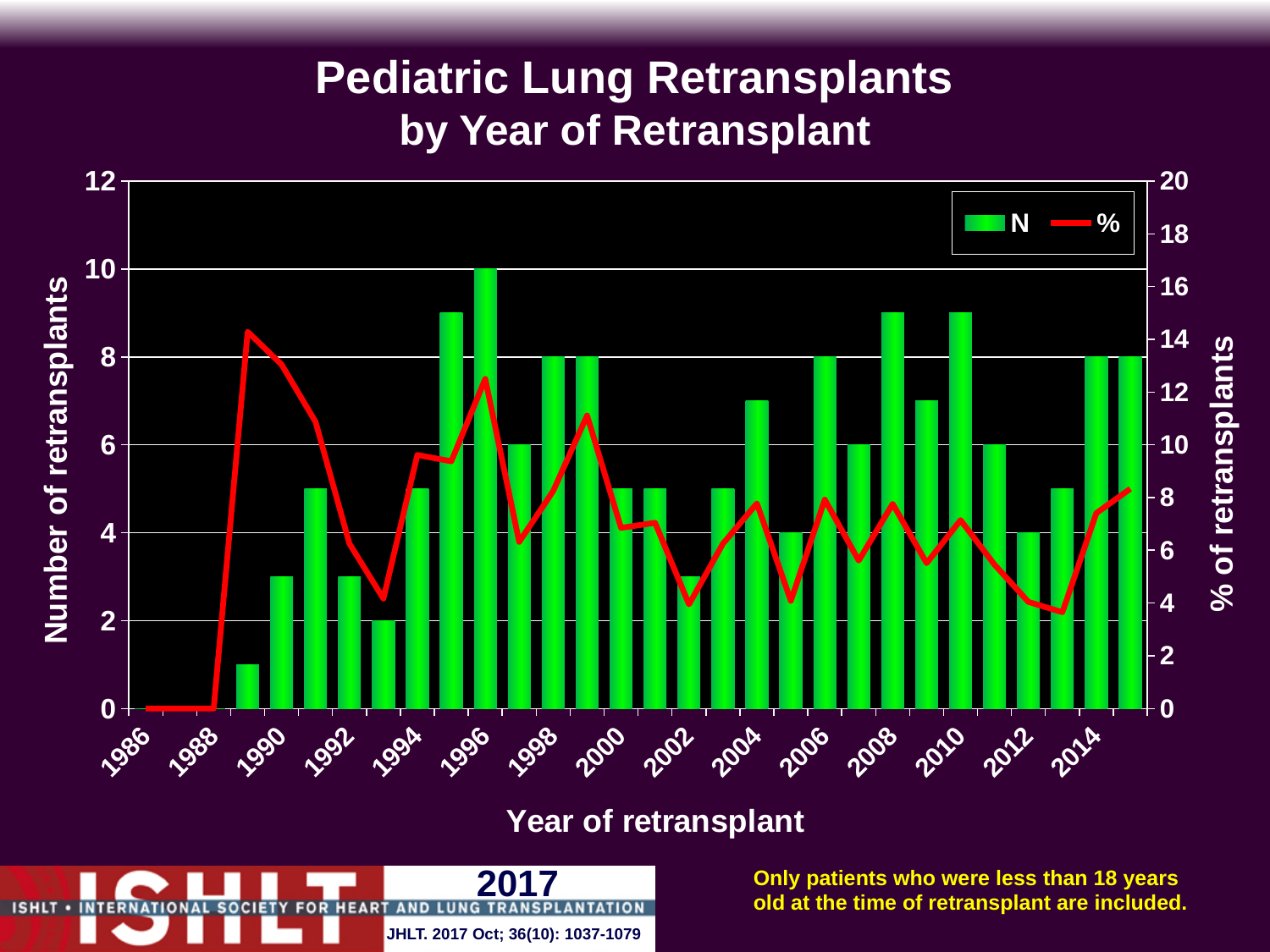
What is the number of retransplants (N) in 1996? 10 What is the number of retransplants (N) in 2012? 4 Is the number of retransplants in 2008 greater or less than 8? greater Do the number of retransplants rise or fall from 2010 to 2012? fall What is the difference in number of retransplants between 1996 and 1998? 2 Which year has more retransplants, 2006 or 2012? 2006 Is the % of retransplants in 1990 greater or less than 12? greater What is the number of retransplants (N) in 2006? 8 Is the number of retransplants in 2002 greater or less than 4? less What is the title of the chart? Pediatric Lung Retransplants by Year of Retransplant Which year has the highest number of retransplants? 1996 How many series does the legend list? 2